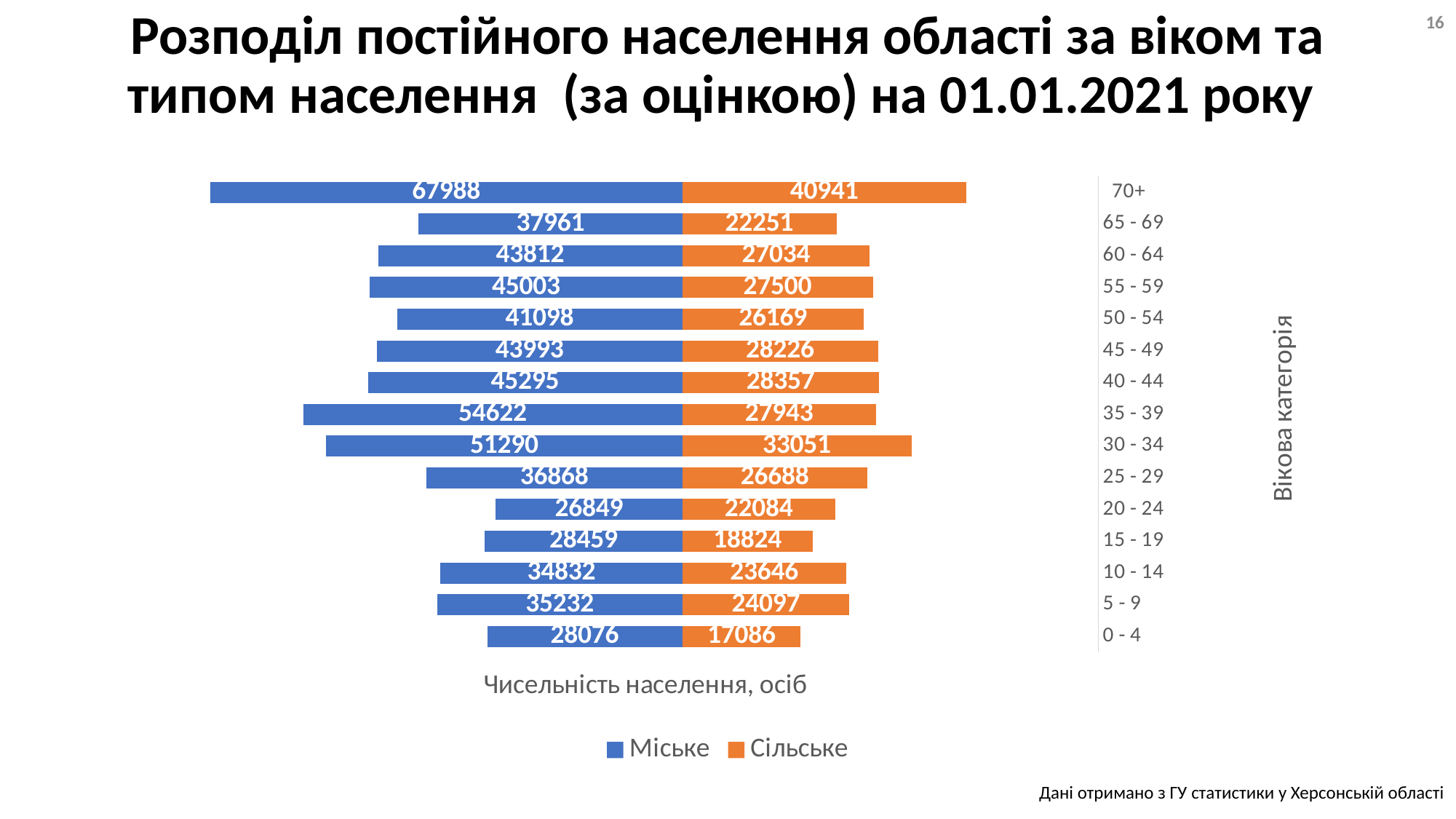
Which age category has the lowest value for Сільське? 0 - 4 Which age category has the highest value for Сільське? 70+ What is the total of the Міське and Сільське values for the 0 - 4 age category? 45162 Which is larger for Міське: the 35 - 39 category or the 30 - 34 category? 35 - 39 How many series does the legend list? 2 What is the value for Міське in the 70+ age category? 67988 How many age categories are shown on the chart? 15 What kind of chart is shown on the slide? Bar chart What is the difference between the Міське and Сільське values in the 70+ age category? 27047 Which age category has the lowest value for Міське? 20 - 24 What is the value for Сільське in the 30 - 34 age category? 33051 What is the value for Міське in the 0 - 4 age category? 28076